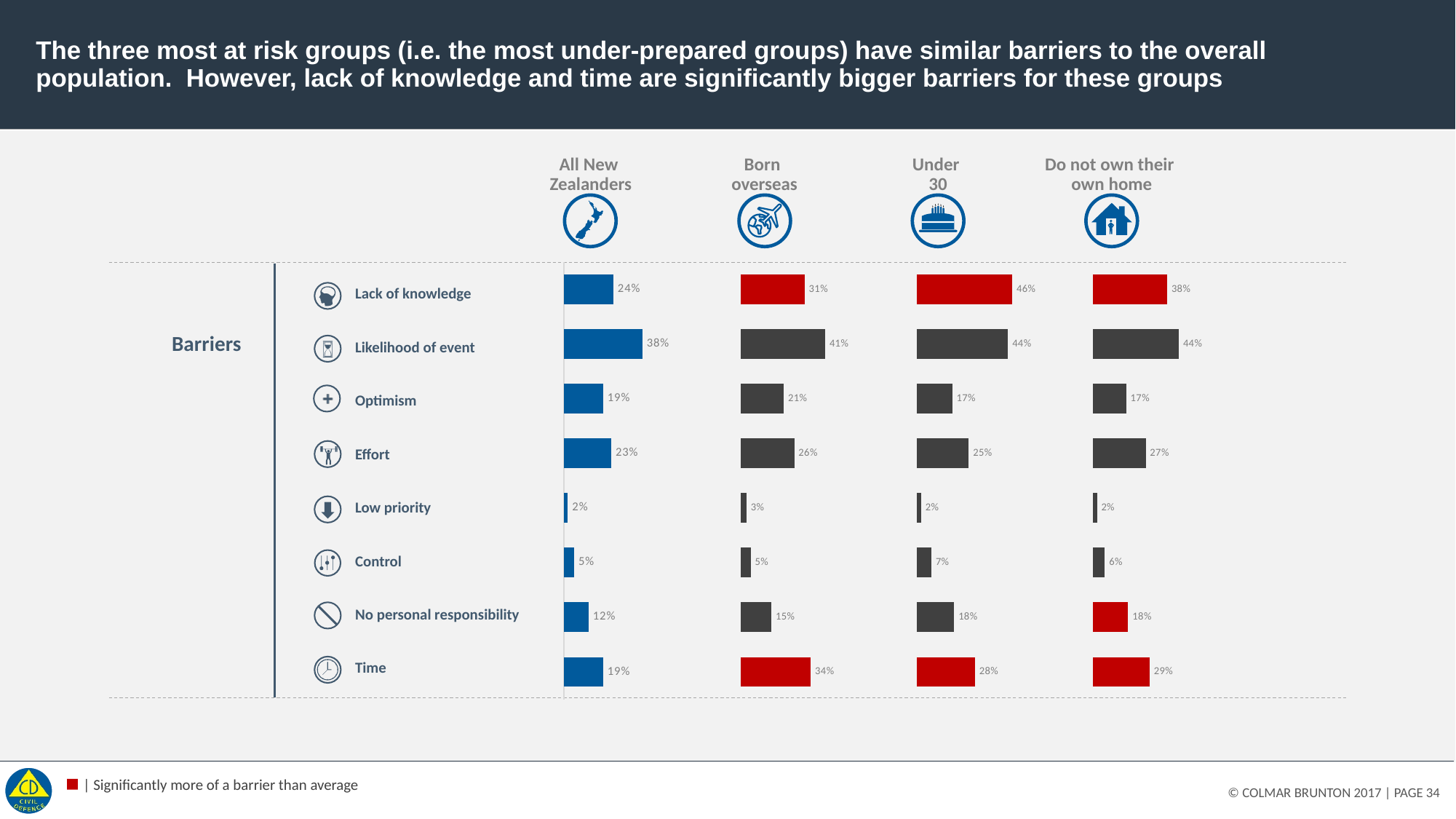
According to the legend at the bottom, what does a red bar indicate? Significantly more of a barrier than average In the Do not own their own home chart, what is the value for No personal responsibility? 18% In the All New Zealanders chart, what is the value for Lack of knowledge? 24% How many barriers are plotted in the All New Zealanders chart? 8 In the Born overseas chart, what is the difference between Time and Effort? 8% In the Born overseas chart, which barrier has the highest value? Likelihood of event In the Under 30 chart, which barrier has the lowest value? Low priority In the Do not own their own home chart, which is larger: Optimism or Effort? Effort In the Under 30 chart, what is the value for Time? 28% Which is larger: Lack of knowledge in the Under 30 chart or Lack of knowledge in the Do not own their own home chart? Under 30 In the Under 30 chart, what is the difference between Lack of knowledge and Likelihood of event? 2% What kind of chart is used for the Born overseas column? Bar chart